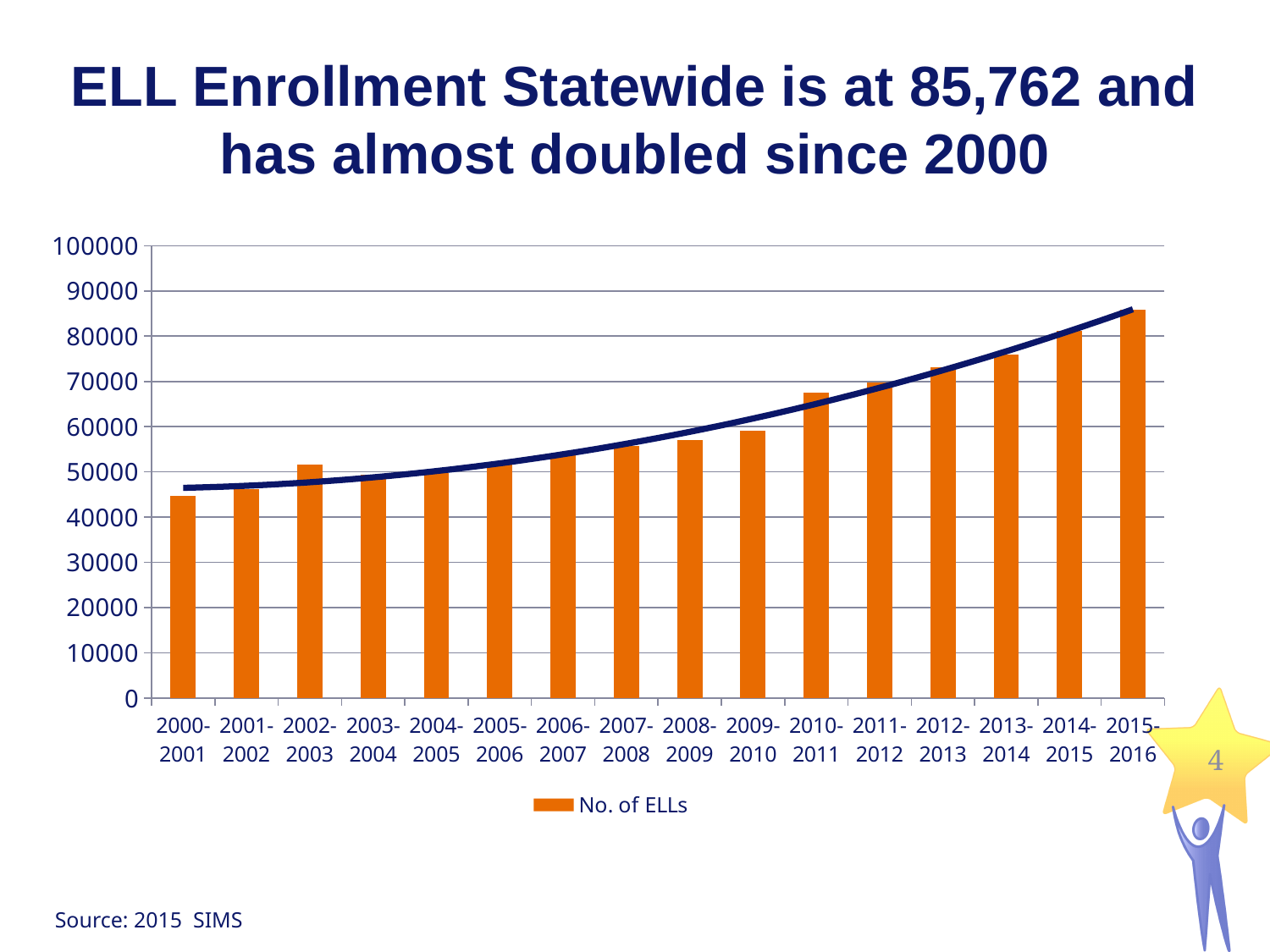
Do the values generally rise or fall from 2000-2001 to 2015-2016? rise Which school year has the lowest number of ELLs? 2000-2001 What is the name of the series shown in the legend? No. of ELLs Is the value for 2010-2011 greater or less than 60000? greater How many series does the legend list? 1 What kind of chart is shown on the slide? bar chart Is the value for 2015-2016 greater or less than 80000? greater Which is larger, the value for 2002-2003 or the value for 2003-2004? 2002-2003 Is the value for 2013-2014 greater or less than 80000? less How many school years are shown on the x axis? 16 Which school year has the highest number of ELLs? 2015-2016